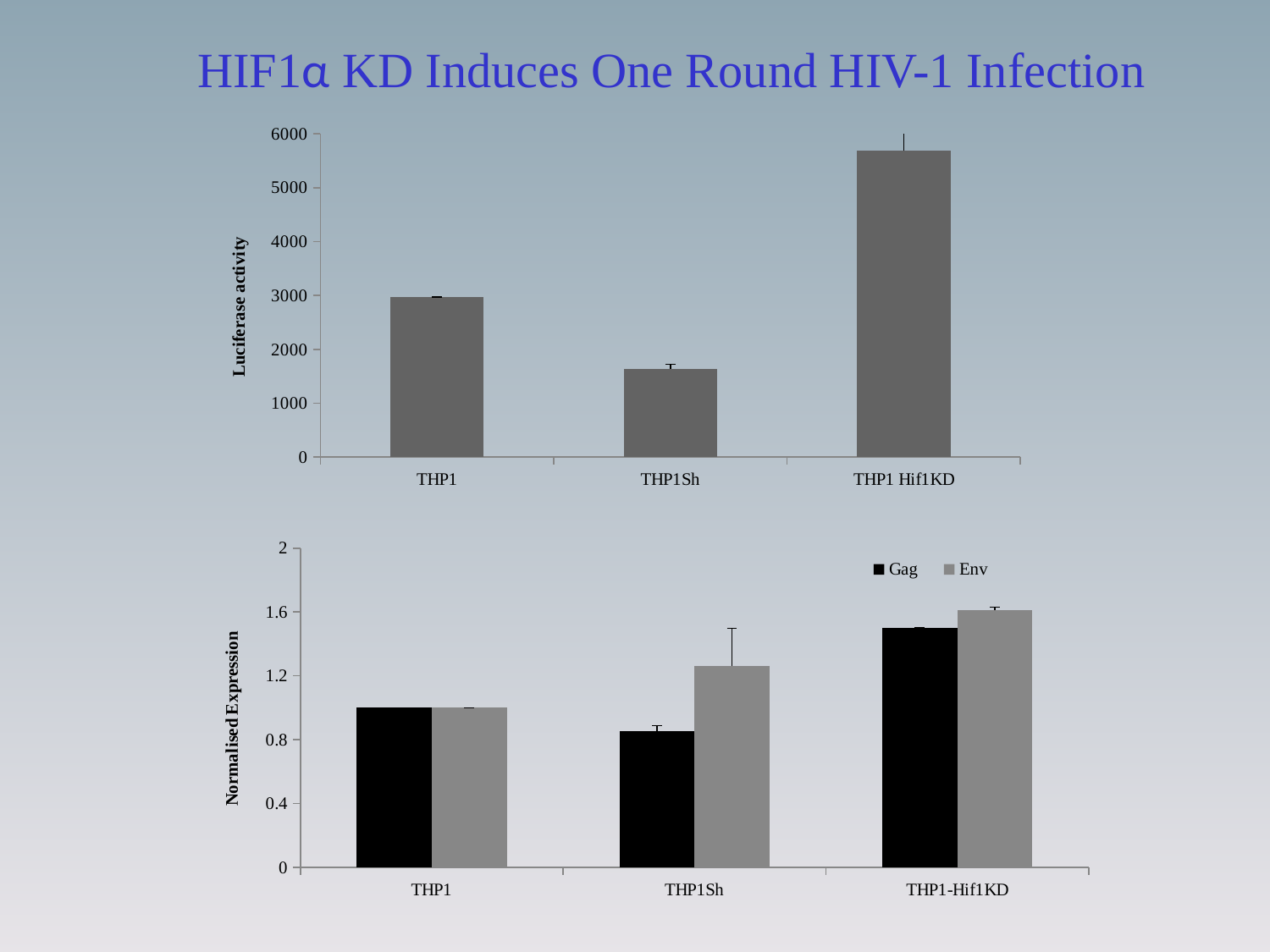
In the top chart (Luciferase activity), is the value for THP1Sh greater or less than 2000? less In the top chart (Luciferase activity), which category has the highest value? THP1 Hif1KD In the bottom chart (Normalised Expression), is the Env value for THP1-Hif1KD greater or less than 1.2? greater In the bottom chart (Normalised Expression), what is the label of the y axis? Normalised Expression What kind of chart is the top chart (Luciferase activity)? bar chart In the bottom chart (Normalised Expression), which is larger for THP1Sh, Gag or Env? Env How many categories are shown on the x axis of the top chart (Luciferase activity)? 3 In the top chart (Luciferase activity), which category has the lowest value? THP1Sh In the top chart (Luciferase activity), is the value for THP1 greater or less than 2000? greater In the bottom chart (Normalised Expression), which category has the highest Gag value? THP1-Hif1KD How many series does the legend of the bottom chart (Normalised Expression) list? 2